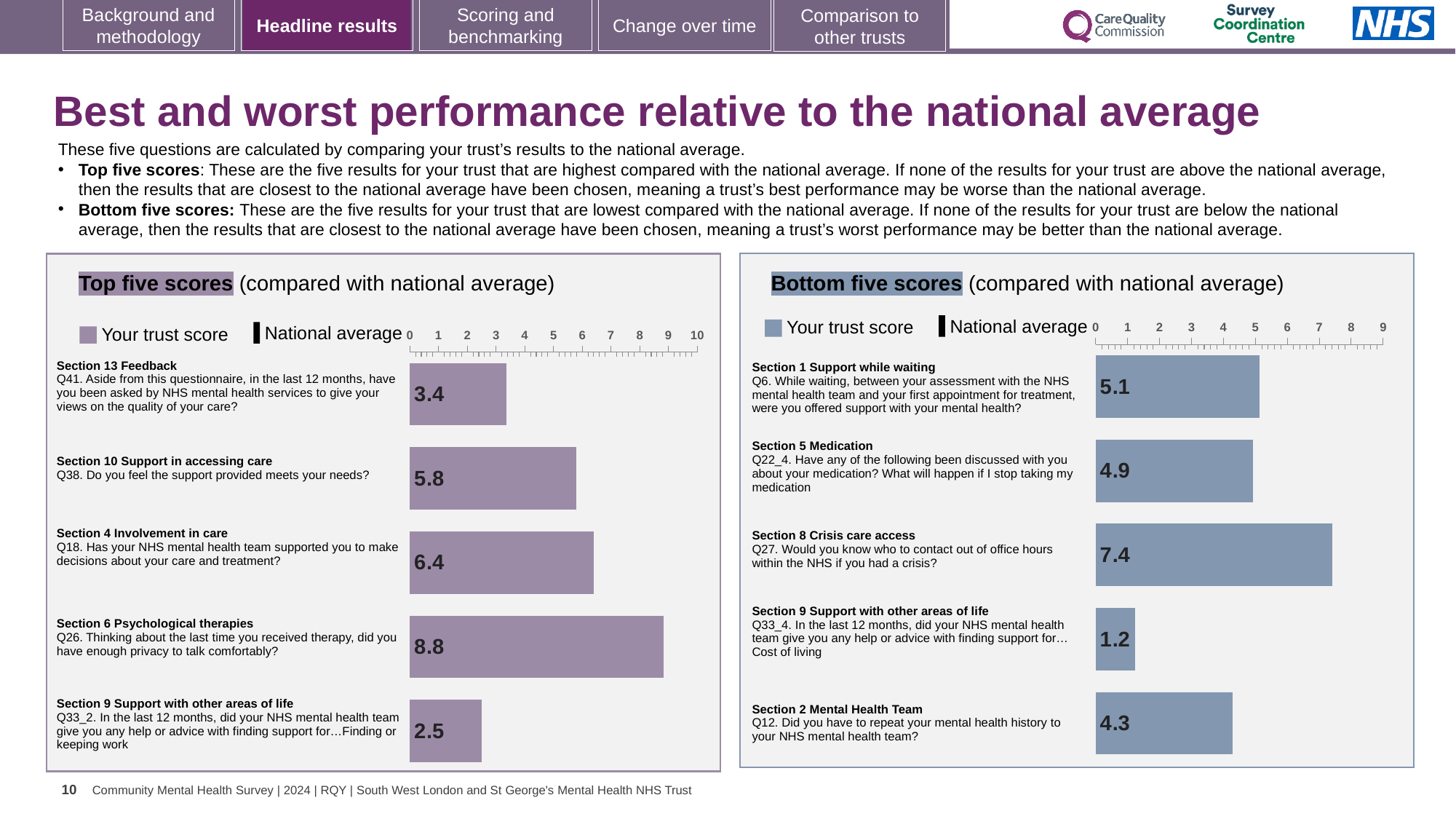
How many bars are plotted in the Top five scores chart? 5 In the Bottom five scores chart, what is the trust score for Q27 (Section 8 Crisis care access)? 7.4 In the Bottom five scores chart, which has the larger trust score: Q6 or Q22_4? Q6 In the Bottom five scores chart, which question has the lowest trust score? Q33_4 (Section 9 Support with other areas of life) In the Top five scores chart, what is the difference between the trust scores for Q26 and Q33_2? 6.3 How many series does the legend of the Bottom five scores chart list? 2 What kind of chart is the Top five scores chart? Bar chart In the Top five scores chart, what is the trust score for Q26 (Section 6 Psychological therapies)? 8.8 In the Bottom five scores chart, what is the trust score for Q12 (Section 2 Mental Health Team)? 4.3 In the Top five scores chart, is the trust score for Q18 greater or less than 5? greater In the Top five scores chart, which question has the highest trust score? Q26 (Section 6 Psychological therapies) What is the highest value shown on the axis of the Top five scores chart? 10